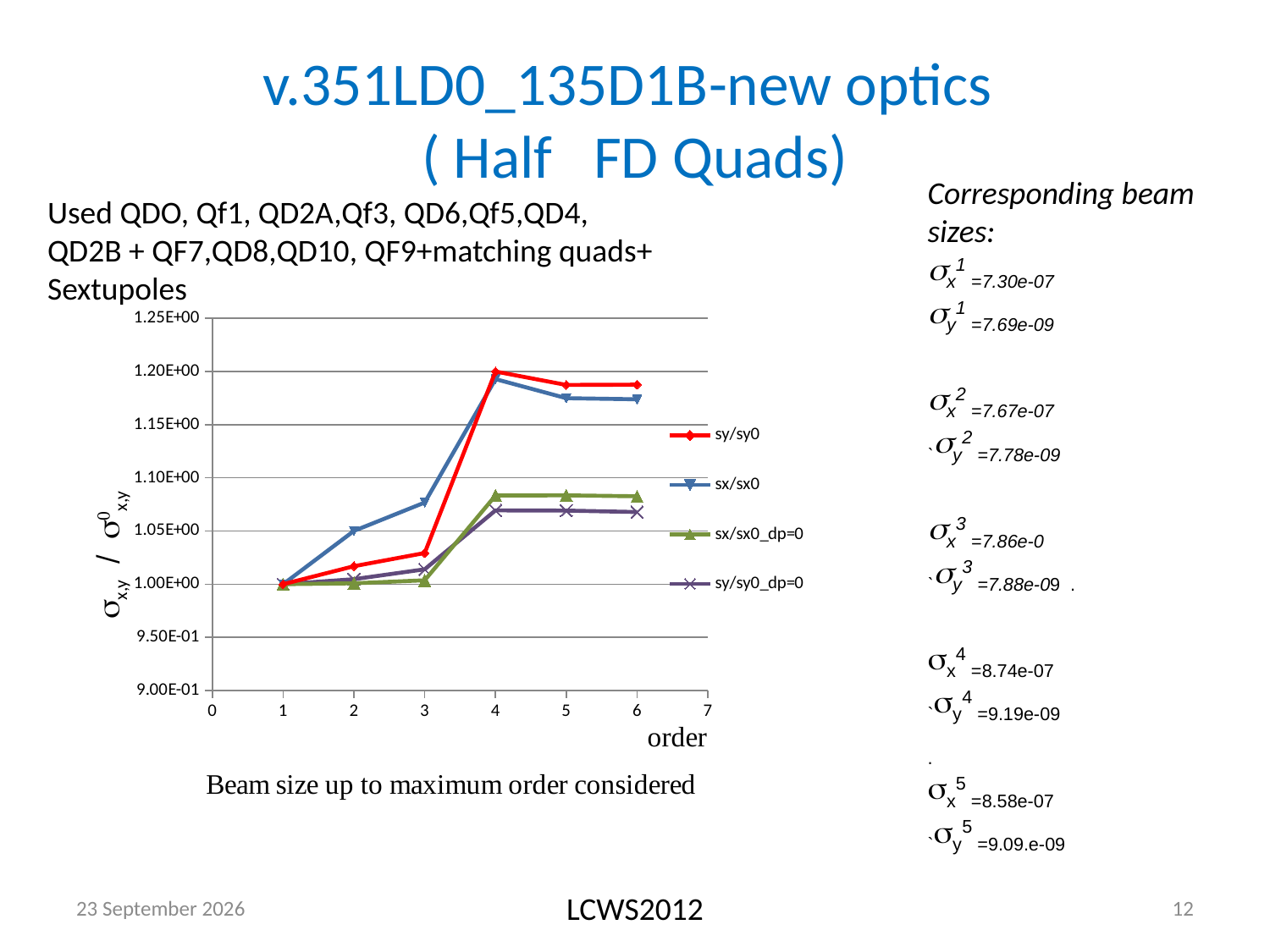
How many series does the chart legend list? 4 Is the value of sy/sy0 at order 6 greater or less than 1.15E+00? greater What is the label of the x axis of the chart? order How many data points are plotted for the sy/sy0 series? 6 What is the value of sy/sy0 at order 1? 1.00E+00 What kind of chart is shown on the slide? line chart Is the value of sx/sx0 at order 2 greater or less than 1.00E+00? greater At order 6, which is larger: sy/sy0 or sx/sx0_dp=0? sy/sy0 Does the sy/sy0 series rise or fall from order 1 to order 4? rise At order 2, which is larger: sx/sx0 or sy/sy0? sx/sx0 Is the value of sx/sx0_dp=0 at order 6 greater or less than 1.10E+00? less Which series has the highest value at order 6? sy/sy0